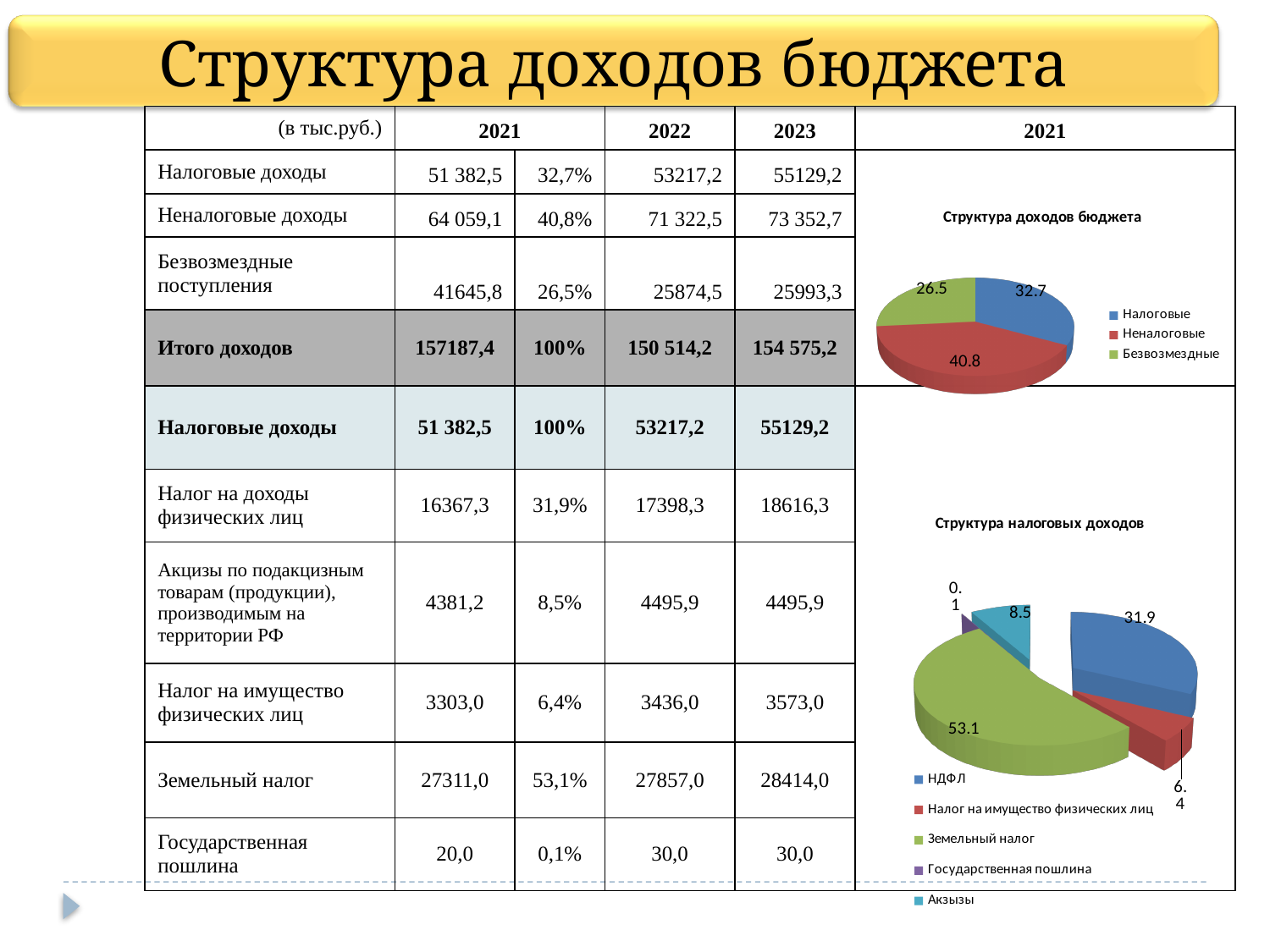
On the chart titled "Структура налоговых доходов", what value is shown for НДФЛ? 31.9 On the chart titled "Структура доходов бюджета", how many slices does the pie have? 3 On the chart titled "Структура доходов бюджета", what value is shown for the Неналоговые slice? 40.8 On the chart titled "Структура доходов бюджета", what is the difference between the Неналоговые and Налоговые values? 8.1 On the chart titled "Структура доходов бюджета", what value is shown for the Безвозмездные slice? 26.5 On the chart titled "Структура налоговых доходов", which category has the smallest slice? Государственная пошлина On the chart titled "Структура доходов бюджета", which category has the largest slice? Неналоговые On the chart titled "Структура налоговых доходов", which is larger: Акцизы or Налог на имущество физических лиц? Акцизы What type of chart is the chart titled "Структура налоговых доходов"? Pie chart On the chart titled "Структура налоговых доходов", how many entries does the legend list? 5 On the chart titled "Структура налоговых доходов", what value is shown for Земельный налог? 53.1 On the chart titled "Структура доходов бюджета", which category has the smallest slice? Безвозмездные